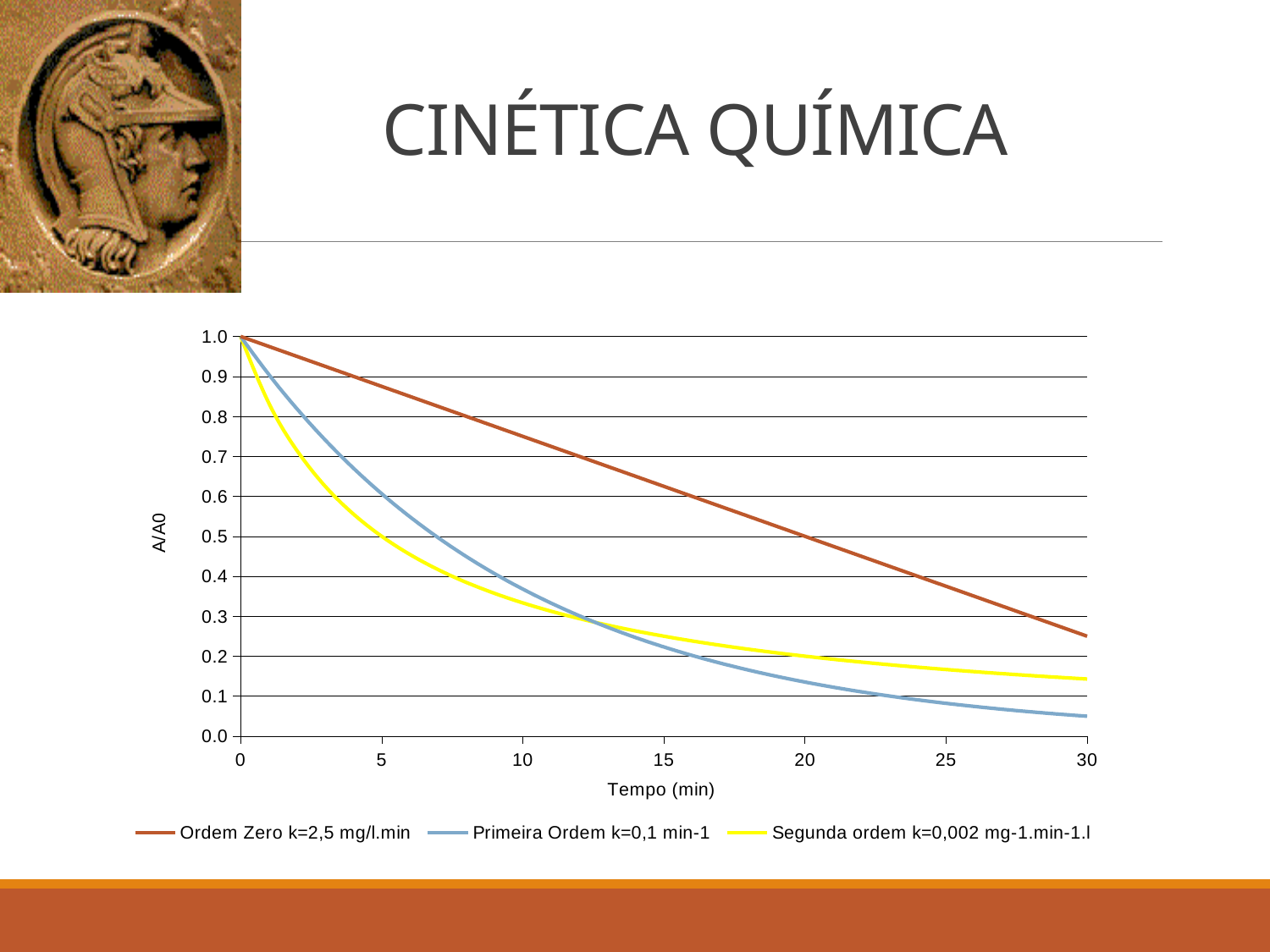
What is the value of A/A0 for all three series at time 0? 1.0 How many series does the legend list? 3 Is the A/A0 value of the Primeira Ordem k=0,1 min-1 series at 10 min greater or less than 0.5? less Which series has the lowest A/A0 value at 30 min? Primeira Ordem k=0,1 min-1 At 5 min, which series has a higher A/A0 value: Ordem Zero k=2,5 mg/l.min or Segunda ordem k=0,002 mg-1.min-1.l? Ordem Zero k=2,5 mg/l.min Is the A/A0 value of the Primeira Ordem k=0,1 min-1 series at 30 min greater or less than 0.1? less Do the A/A0 values rise or fall as Tempo (min) increases? fall Which series has the highest A/A0 value at 30 min? Ordem Zero k=2,5 mg/l.min Is the A/A0 value of the Ordem Zero k=2,5 mg/l.min series at 30 min greater or less than 0.2? greater What is the A/A0 value of the Ordem Zero k=2,5 mg/l.min series at 20 min? 0.5 What kind of chart is shown on the slide? line chart